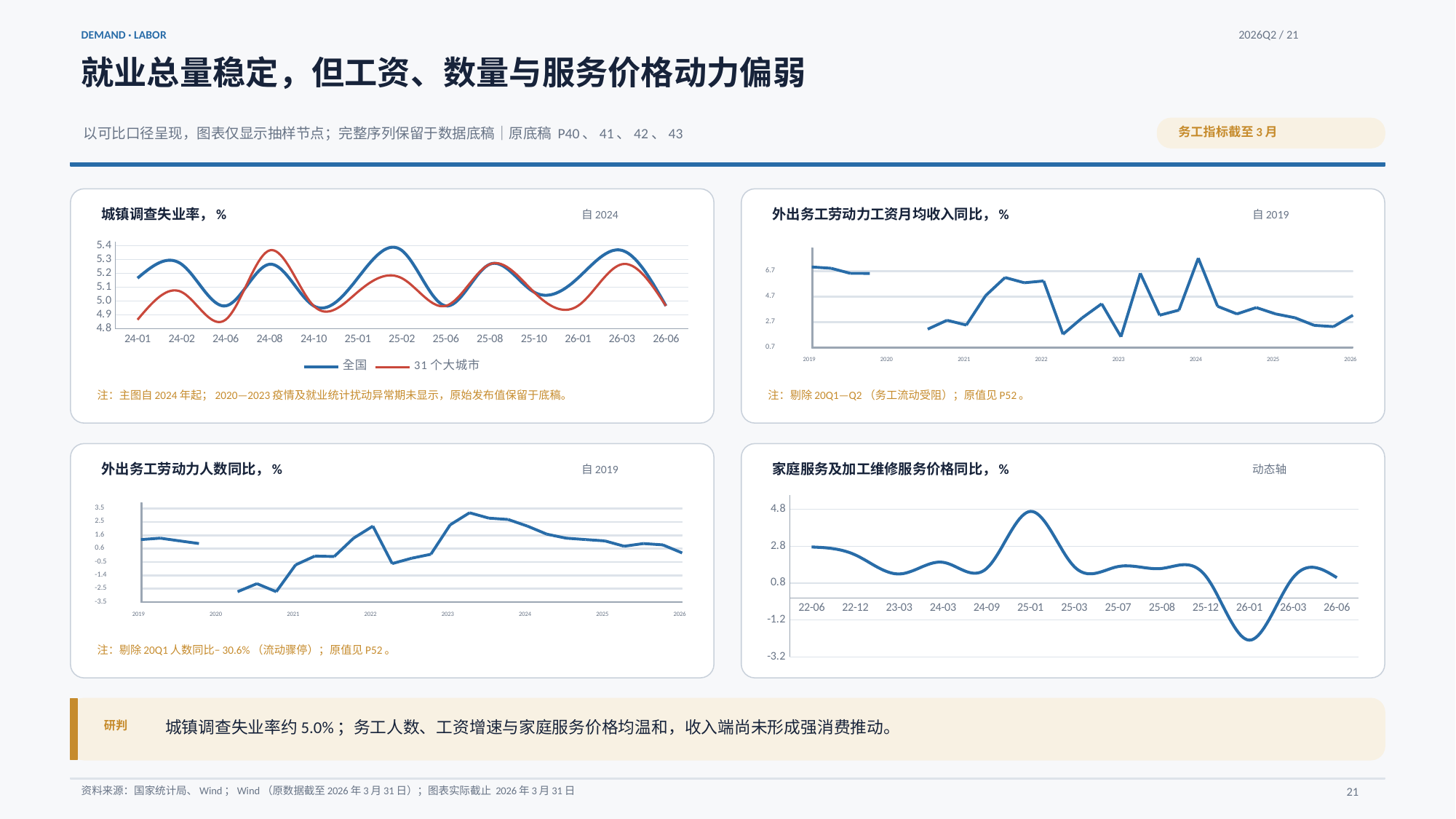
In the 城镇调查失业率，% chart, is the 31 个大城市 value at 24-01 greater or less than 5.0? less In the 外出务工劳动力人数同比，% chart, is the value at 2026 greater or less than 0.6? less In the 外出务工劳动力工资月均收入同比，% chart, is the value at 2024 greater or less than 6.7? greater How many series does the legend of the 城镇调查失业率，% chart list? 2 In the 城镇调查失业率，% chart, which series has the higher value at 24-08, 全国 or 31 个大城市? 31 个大城市 In the 家庭服务及加工维修服务价格同比，% chart, at which x-axis label is the value lowest? 26-01 How many x-axis labels are shown on the 城镇调查失业率，% chart? 13 What kind of chart is the 城镇调查失业率，% chart? line chart In the 城镇调查失业率，% chart, which series is drawn in red? 31 个大城市 In the 家庭服务及加工维修服务价格同比，% chart, at which x-axis label is the value highest? 25-01